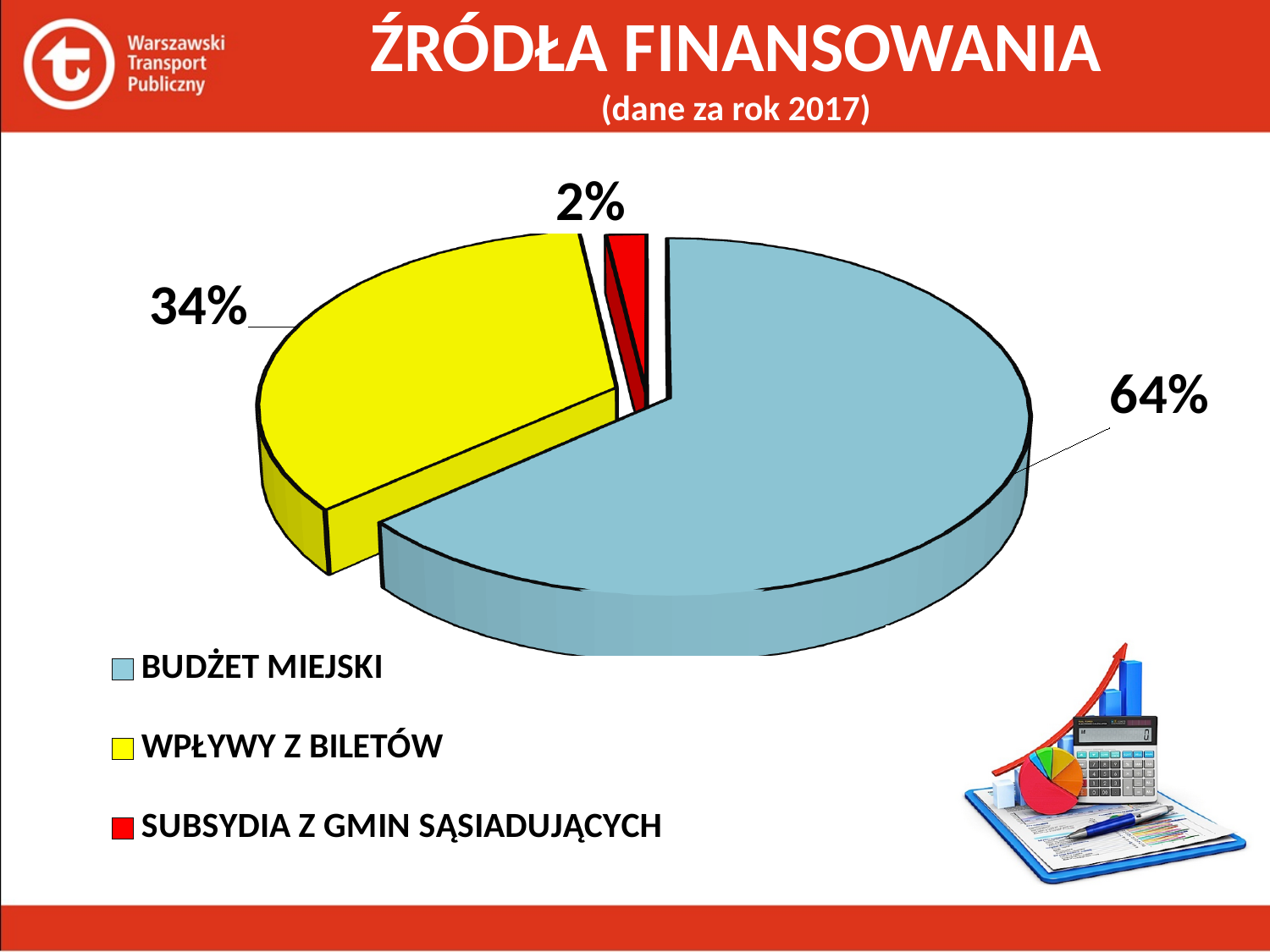
Which is larger, the share for WPŁYWY Z BILETÓW or the share for SUBSYDIA Z GMIN SĄSIADUJĄCYCH? WPŁYWY Z BILETÓW How many categories does the pie chart have? 3 Which category has the smallest share of the pie? SUBSYDIA Z GMIN SĄSIADUJĄCYCH What share of the pie does WPŁYWY Z BILETÓW have? 34% What is the title of the chart on the slide? ŹRÓDŁA FINANSOWANIA Which category has the largest share of the pie? BUDŻET MIEJSKI What is the combined share of WPŁYWY Z BILETÓW and SUBSYDIA Z GMIN SĄSIADUJĄCYCH? 36% What share of the pie does BUDŻET MIEJSKI have? 64% What is the difference in percentage points between BUDŻET MIEJSKI and WPŁYWY Z BILETÓW? 30 What share of the pie does SUBSYDIA Z GMIN SĄSIADUJĄCYCH have? 2% Which colour represents WPŁYWY Z BILETÓW in the pie chart? yellow What kind of chart is shown on the slide? pie chart